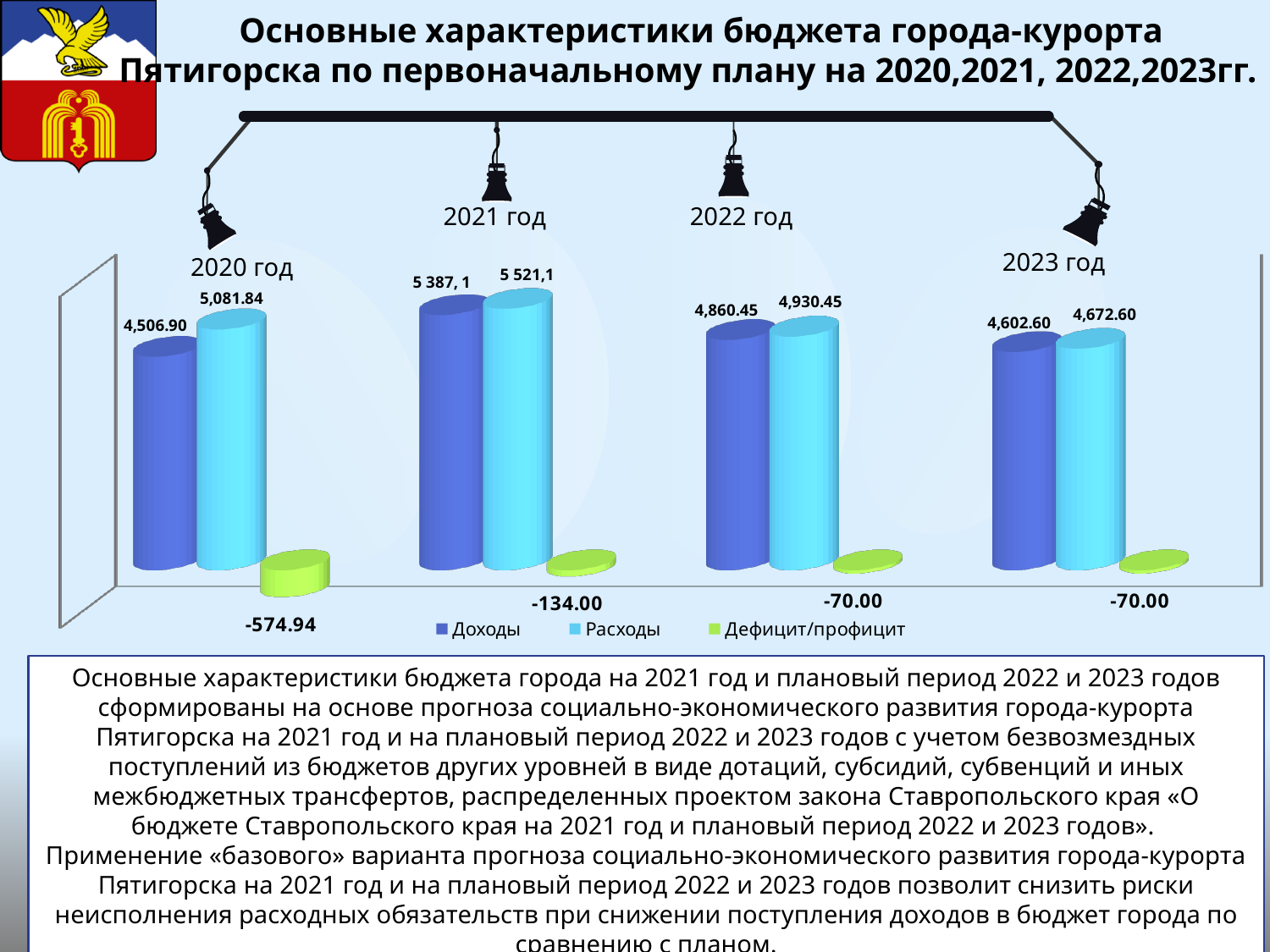
How many years are shown on the chart? 4 What is the difference between Расходы and Доходы for 2022 год? 70.00 Do the Доходы values rise or fall from 2021 год to 2023 год? fall In which year is Доходы the highest? 2021 год In which year is Расходы the lowest? 2023 год What is the value of Доходы for 2020 год? 4,506.90 Which is larger, Доходы for 2022 год or Доходы for 2023 год? 2022 год What is the value of Дефицит/профицит for 2020 год? -574.94 What is the value of Расходы for 2021 год? 5 521,1 How many series does the legend list? 3 What is the value of Доходы for 2023 год? 4,602.60 What kind of chart is shown on the slide? bar chart